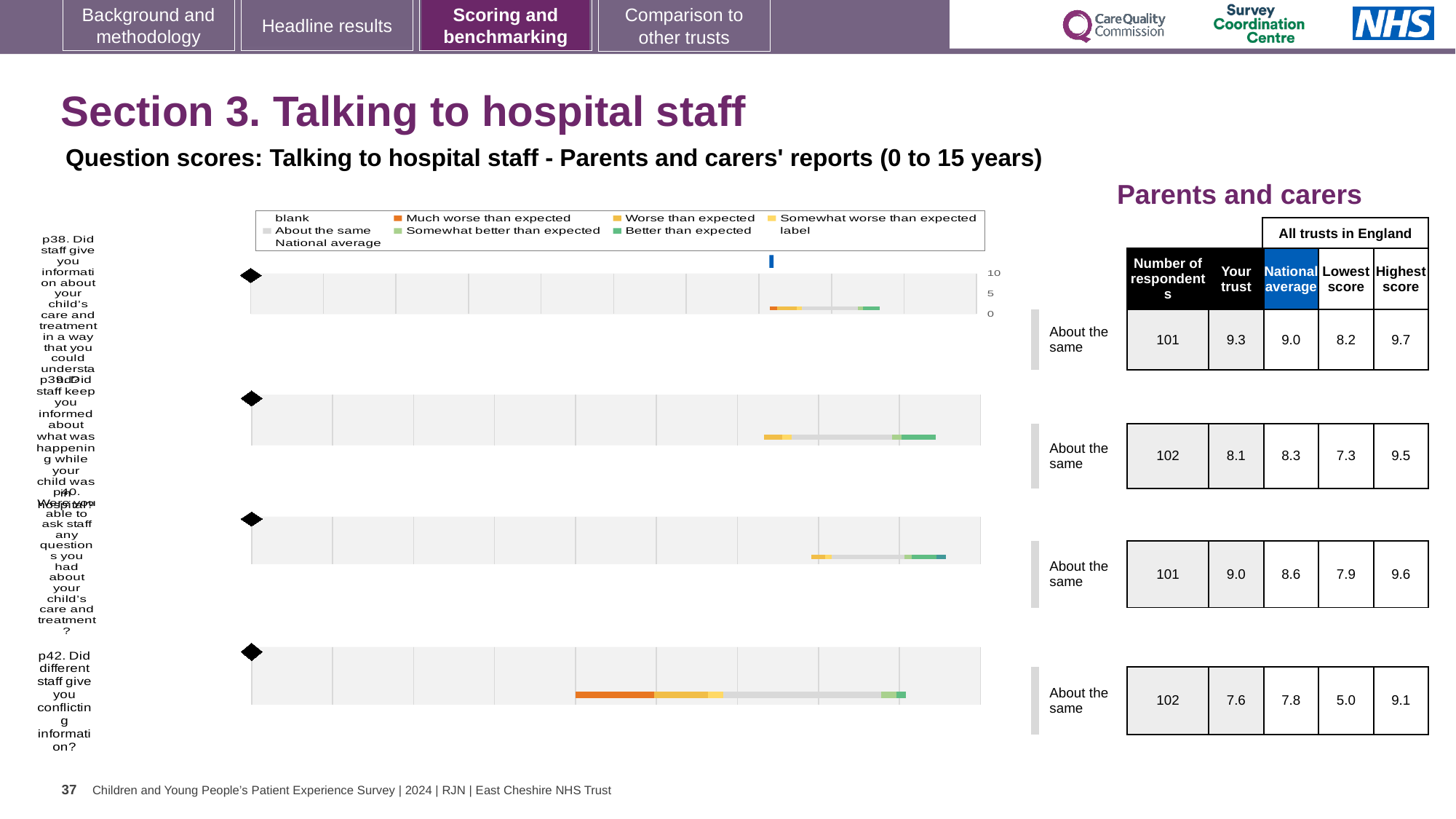
For p39, which is larger: the 'Your trust' score or the National average? National average What benchmark category is shown for all four questions? About the same How many respondents answered p40 (Were you able to ask staff any questions you had about your child's care and treatment)? 101 What is the National average score for p42 (Did different staff give you conflicting information)? 7.8 What kind of chart is used to show the question scores on this slide? bar chart Which question has the highest 'Your trust' score? p38 What is the 'Your trust' score for p38 (Did staff give you information about your child's care and treatment in a way that you could understand)? 9.3 How many questions (bars) are plotted in the chart? 4 Which question has the lowest 'Your trust' score? p42 What is the Lowest score across all trusts in England for p42? 5.0 How many entries does the chart legend list? 9 For p38, what is the difference between the Highest score and the Lowest score across all trusts in England? 1.5